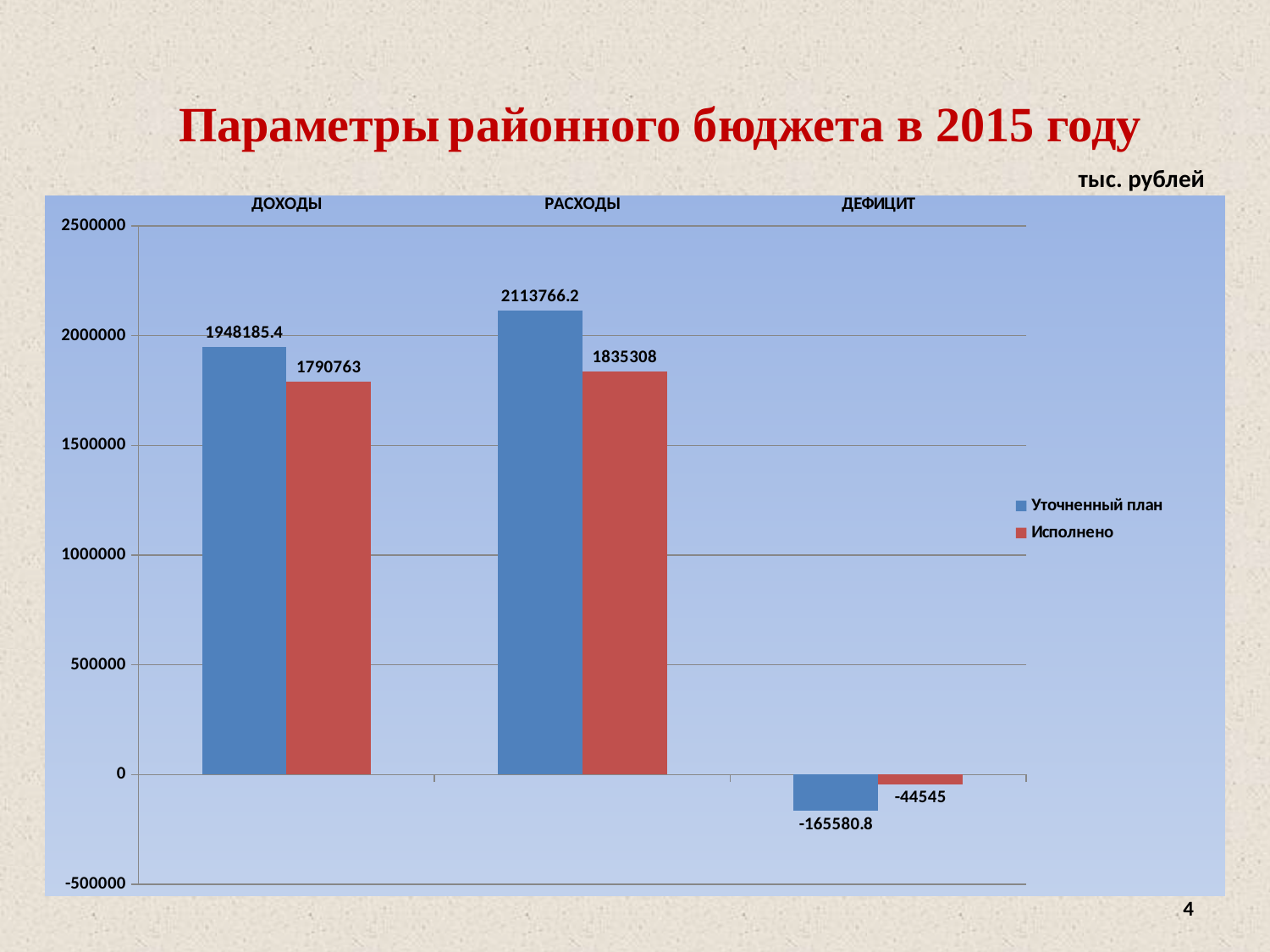
What is the value of Исполнено for ДЕФИЦИТ? -44545 What is the value of Исполнено for РАСХОДЫ? 1835308 How many categories are shown on the x axis? 3 What kind of chart is shown on the slide? Bar chart What is the value of Уточненный план for ДЕФИЦИТ? -165580.8 Which category has the lowest Исполнено value? ДЕФИЦИТ What is the value of Уточненный план for ДОХОДЫ? 1948185.4 What is the difference between Уточненный план and Исполнено for ДОХОДЫ? 157422.4 Which category has the highest Уточненный план value? РАСХОДЫ Which is larger: Исполнено for ДОХОДЫ or Исполнено for РАСХОДЫ? Исполнено for РАСХОДЫ What is the difference between Уточненный план and Исполнено for РАСХОДЫ? 278458.2 How many series does the legend list? 2